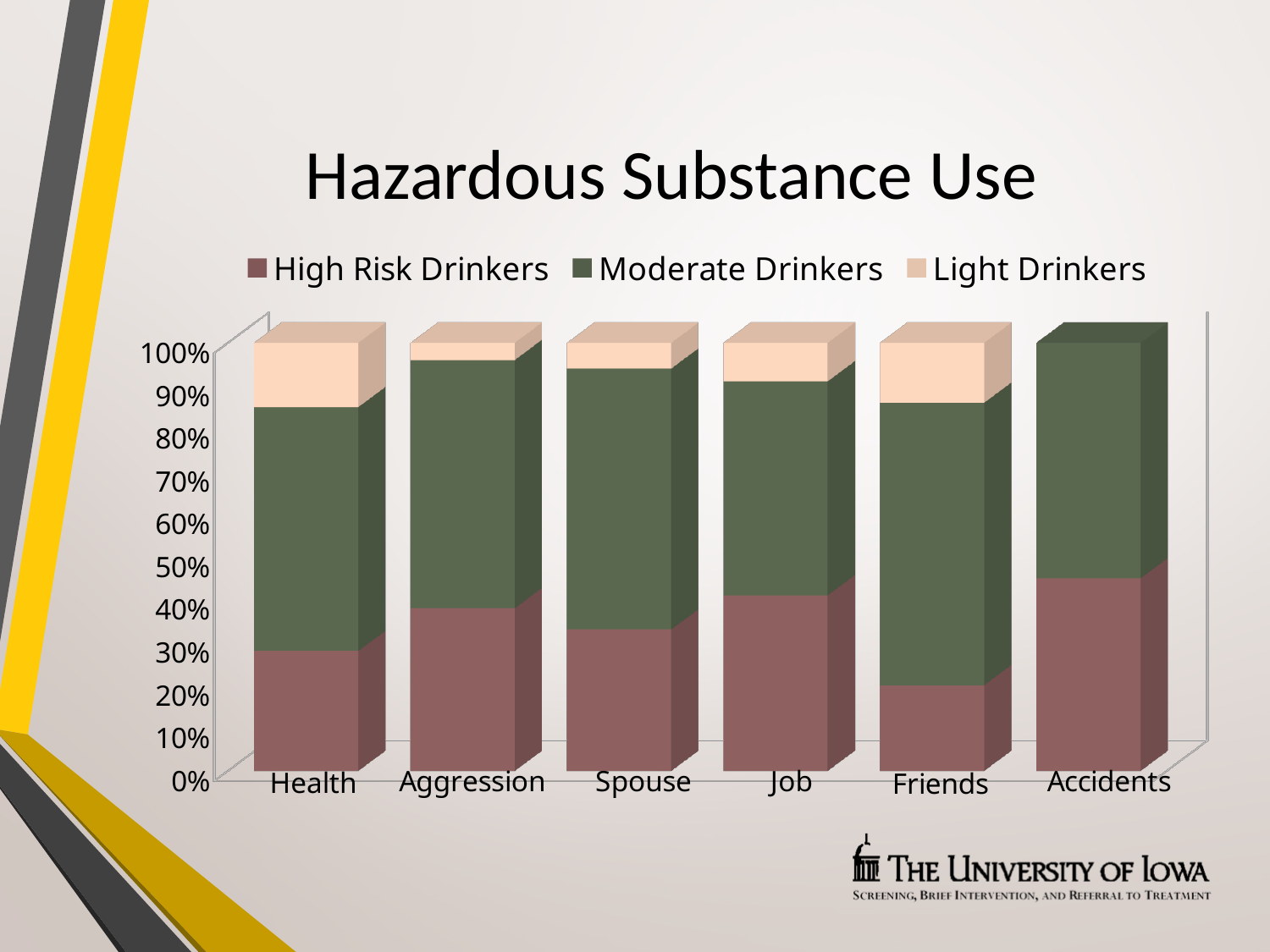
Which legend entry is shown in the light peach colour? Light Drinkers Which category has the largest High Risk Drinkers share? Accidents Is the High Risk Drinkers share for Friends greater or less than 30%? less Which is larger, the High Risk Drinkers share for Job or for Friends? Job What kind of chart is shown on the slide? Stacked bar chart Which category has the smallest High Risk Drinkers share? Friends How many categories are shown on the x axis? 6 How many series does the legend list? 3 What is the title of the chart? Hazardous Substance Use Which category has the largest Moderate Drinkers share? Friends Which category has the smallest Light Drinkers share? Accidents